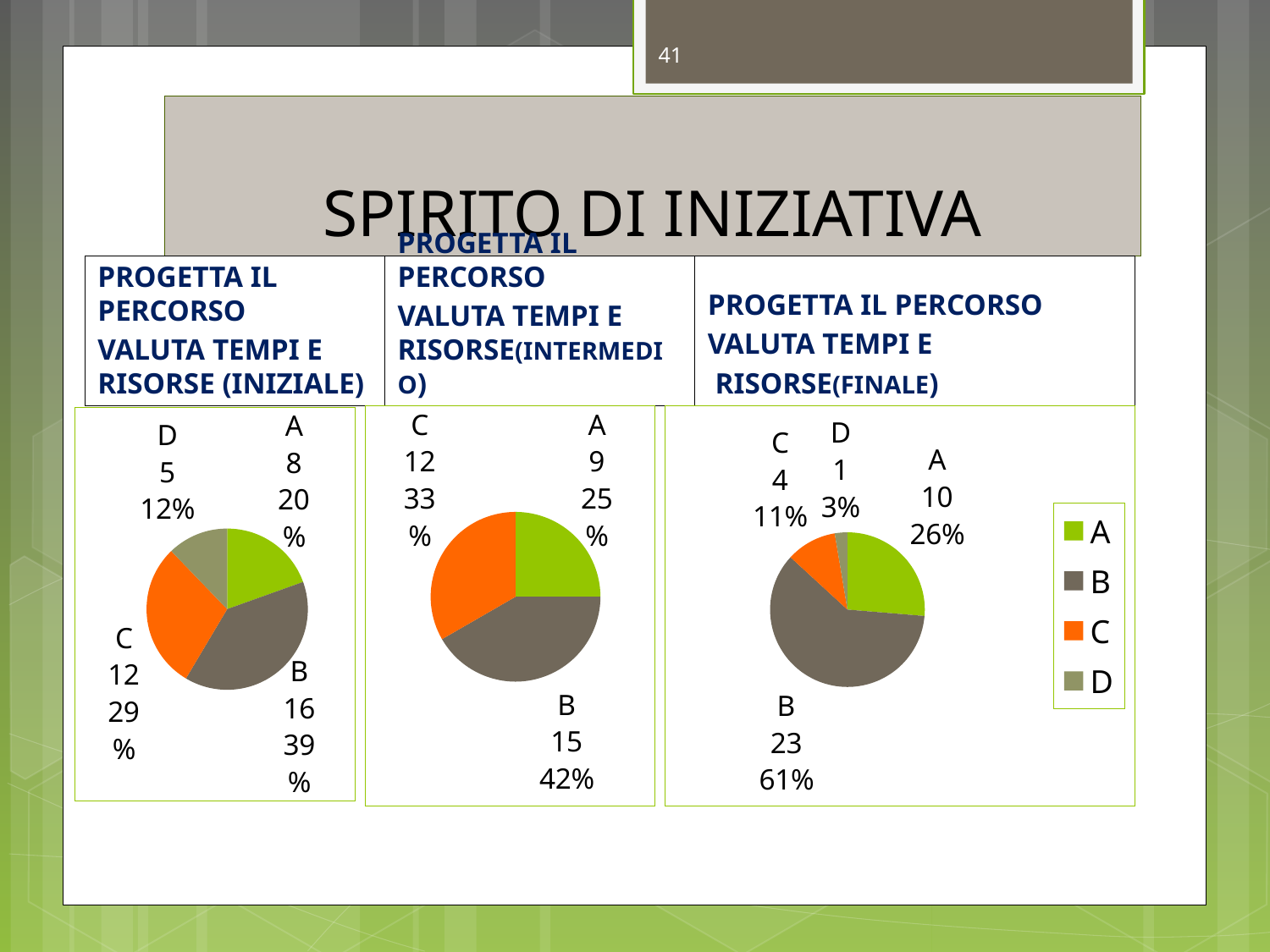
In the right pie chart (FINALE), what is the value for B? 23 In the right pie chart (FINALE), what is the difference between the values for B and A? 13 What type of chart is used on this slide? Pie chart How many entries does the legend on the right of the slide list? 4 In the middle pie chart (INTERMEDIO), what is the value for C? 12 In the left pie chart (INIZIALE), which category has the smallest value? D In the left pie chart (INIZIALE), what percentage share does C have? 29% In the right pie chart (FINALE), what percentage share does D have? 3% In the left pie chart (INIZIALE), what is the value for B? 16 In the right pie chart (FINALE), which is larger, the value for A or the value for C? A In the middle pie chart (INTERMEDIO), which category has the largest share? B How many slices does the middle pie chart (INTERMEDIO) have? 3